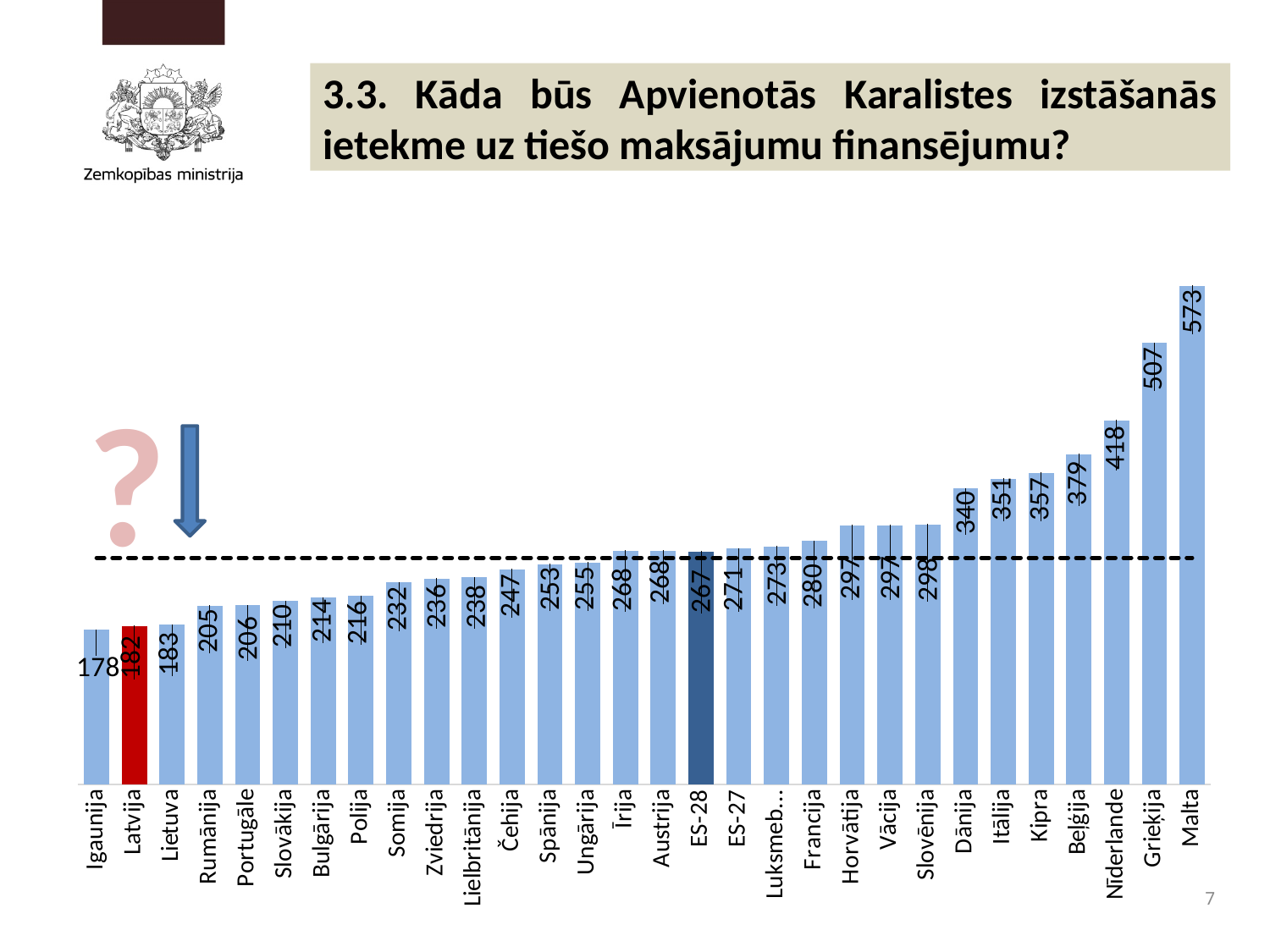
What is the difference between the values for ES-27 and ES-28? 4 What kind of chart is shown on the slide? bar chart Which category has the lowest value? Igaunija How many categories are shown on the x axis? 30 Do the values rise or fall from left to right along the x axis? rise What is the value for ES-28? 267 What is the difference between the values for Malta and Igaunija? 395 What is the value for Lielbritānija? 238 What is the value for Latvija? 182 Which is larger, the value for Dānija or the value for Slovēnija? Dānija Which category has the highest value? Malta What is the value for Malta? 573